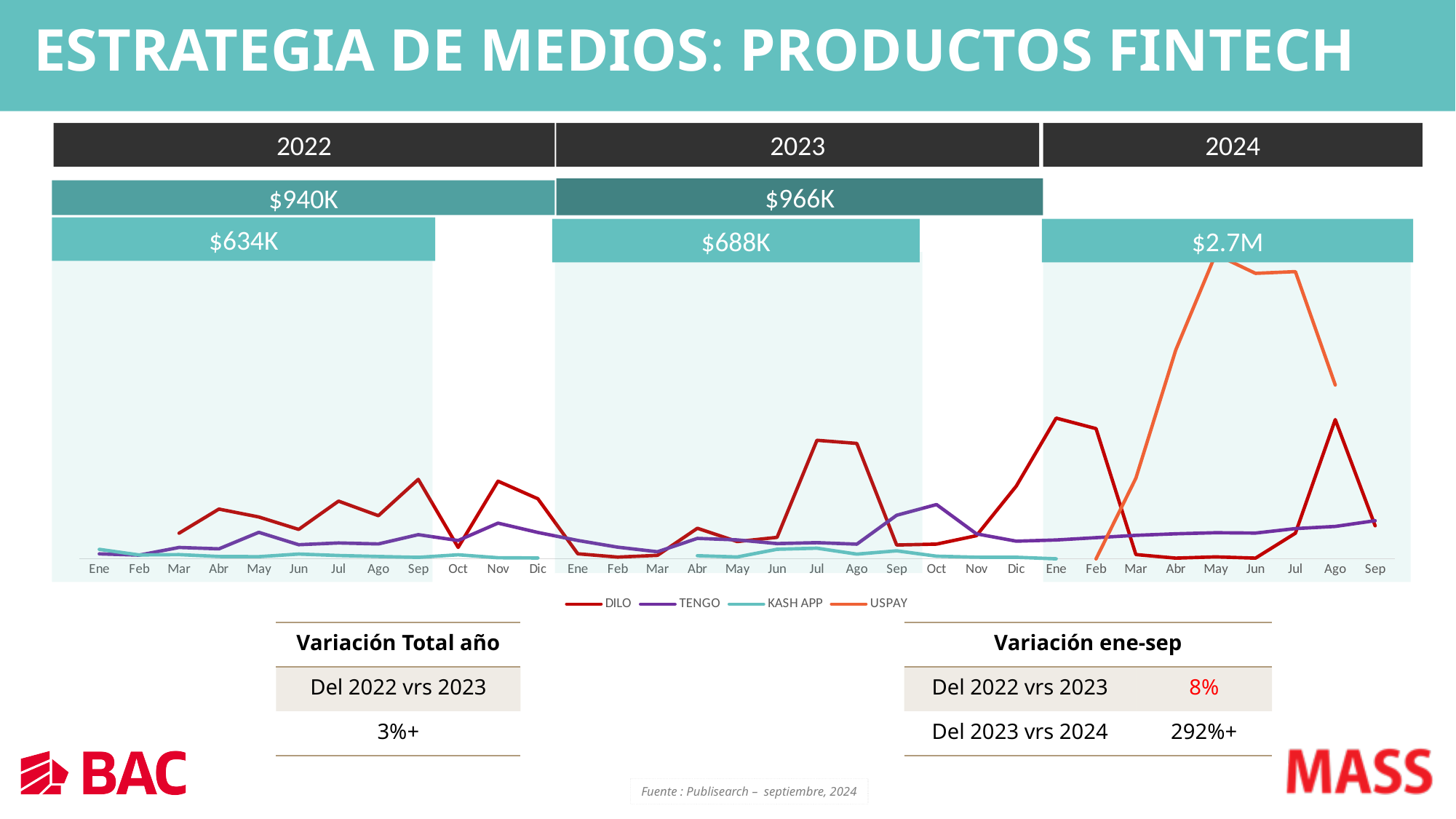
What is the difference between the ene-sep totals for 2023 ($688K) and 2022 ($634K)? $54K Which series are listed in the legend? DILO, TENGO, KASH APP, USPAY Does the USPAY line rise or fall from May 2024 to Ago 2024? fall Which series reaches the highest point in 2024? USPAY What is the difference between the full-year totals for 2023 and 2022? $26K What is the full-year total shown for 2023? $966K What kind of chart is shown on the slide? line chart What is the full-year total shown for 2022? $940K What is the ene-sep total shown for 2024? $2.7M Which year has the highest ene-sep total? 2024 How many months are plotted for 2024? 9 How many series does the legend list? 4